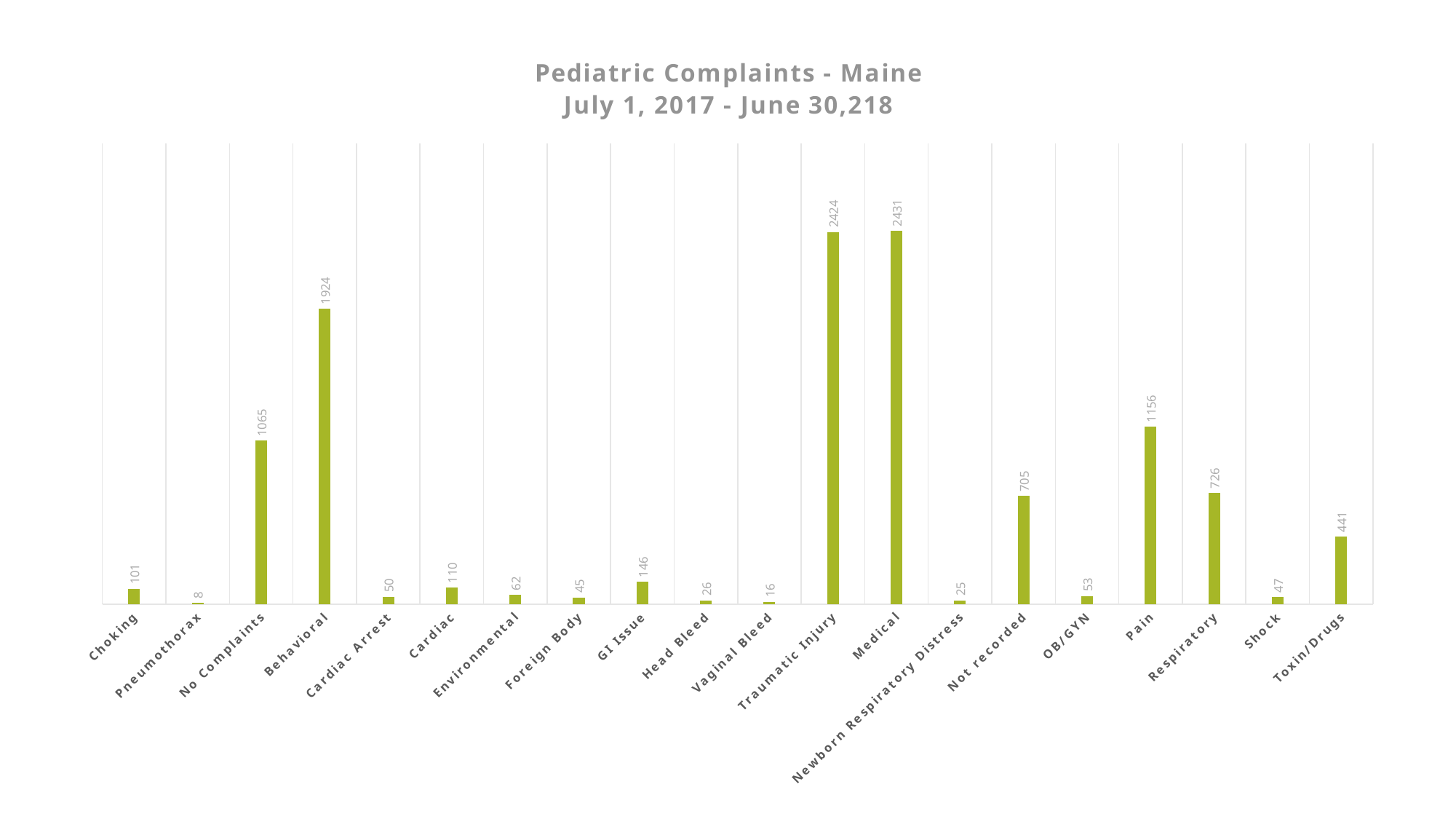
Which is larger, the value for Pain or the value for No Complaints? Pain What is the value for Behavioral? 1924 Which category has the lowest value? Pneumothorax What is the title of the chart? Pediatric Complaints - Maine July 1, 2017 - June 30,218 What is the difference between the values for Behavioral and No Complaints? 859 What is the value for Newborn Respiratory Distress? 25 What kind of chart is this? Bar chart How many categories are shown on the chart? 20 Which category has the highest value? Medical What is the value for Not recorded? 705 What is the difference between the values for Pain and Respiratory? 430 What is the value for Toxin/Drugs? 441